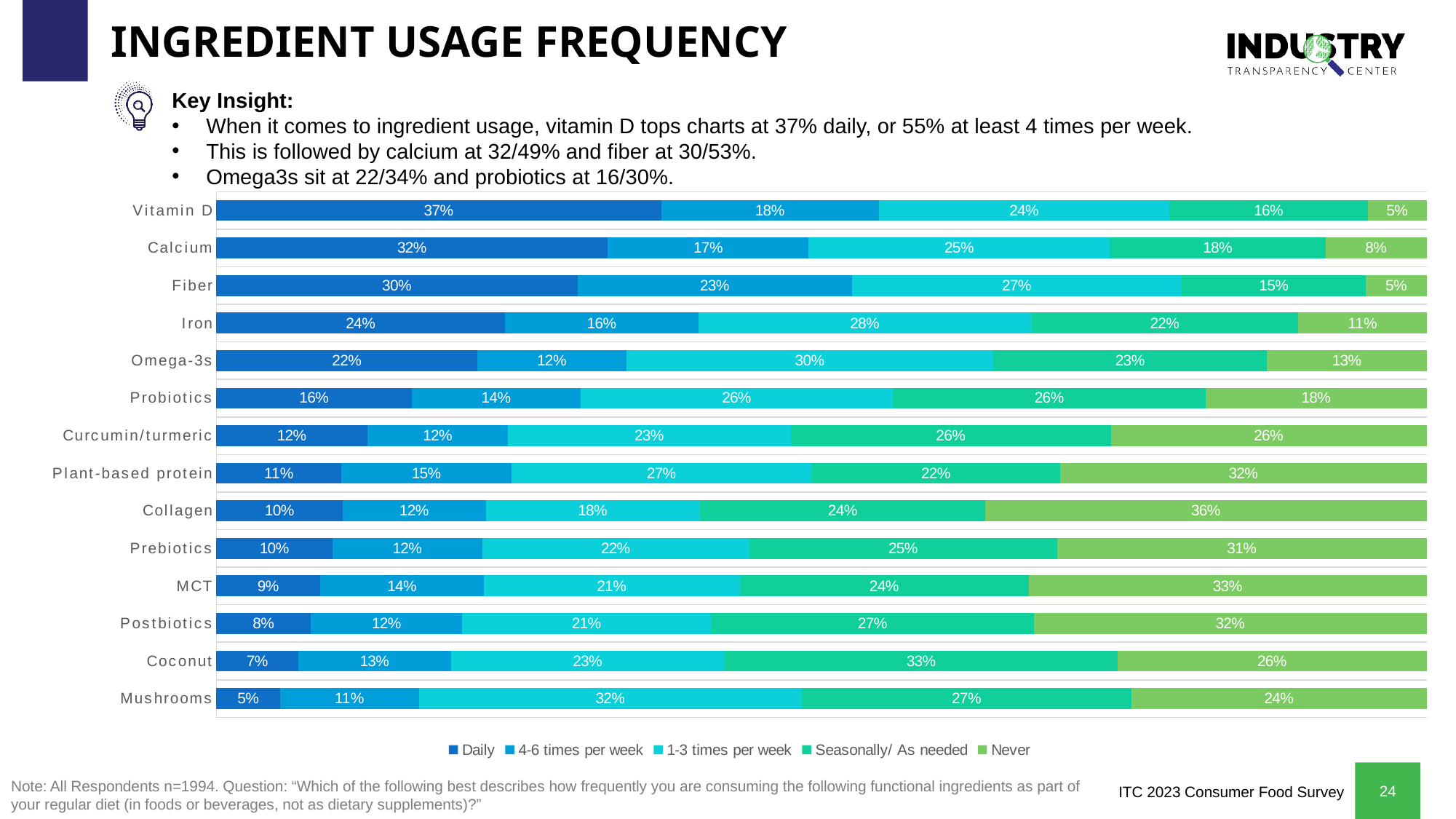
What kind of chart is shown on the slide? Stacked bar chart How many ingredients are shown in the chart? 14 What is the difference between the 'Daily' values for Vitamin D and Calcium? 5% Which ingredient has the highest 'Daily' value? Vitamin D What percentage of respondents use Vitamin D daily? 37% Which ingredient has the highest 'Never' value? Collagen Which ingredient has the lowest 'Daily' value? Mushrooms What is the '1-3 times per week' value for Mushrooms? 32% How many series does the legend list? 5 What is the 'Never' value for Collagen? 36% Which has a larger '1-3 times per week' value, Iron or Omega-3s? Omega-3s What is the 'Seasonally/ As needed' value for Coconut? 33%